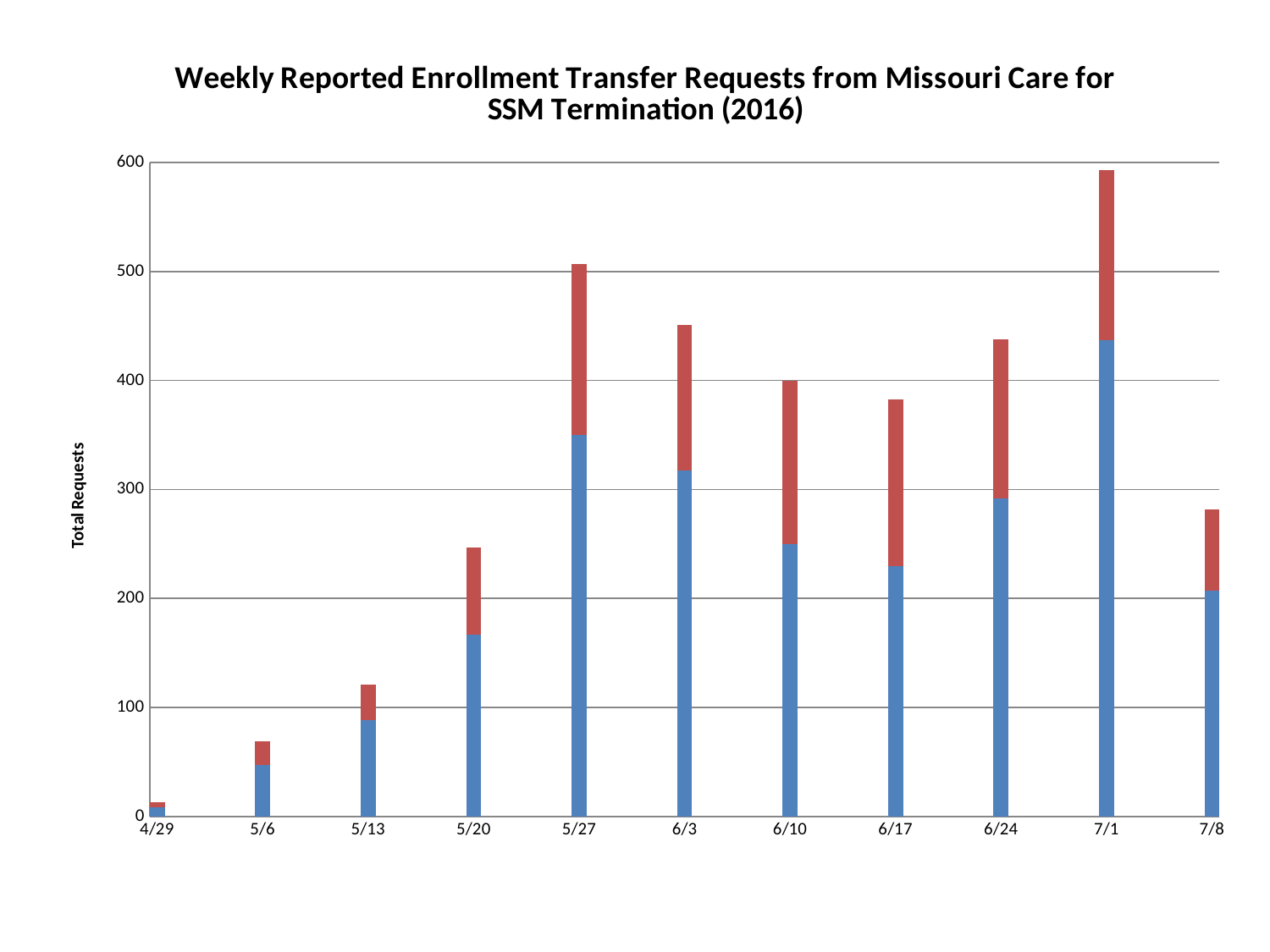
Which week has the highest total requests? 7/1 Which week has a larger total, 5/27 or 6/3? 5/27 Which week has the lowest total requests? 4/29 How many weekly dates are shown on the x axis? 11 What kind of chart is shown on the slide? Stacked bar chart Is the total for 6/17 greater or less than 400? less Is the total for 6/3 greater or less than 400? greater Is the total for 5/6 greater or less than 100? less Do the totals rise or fall from 4/29 to 5/27? rise Which week has a larger total, 6/24 or 7/8? 6/24 What is the label on the vertical axis? Total Requests